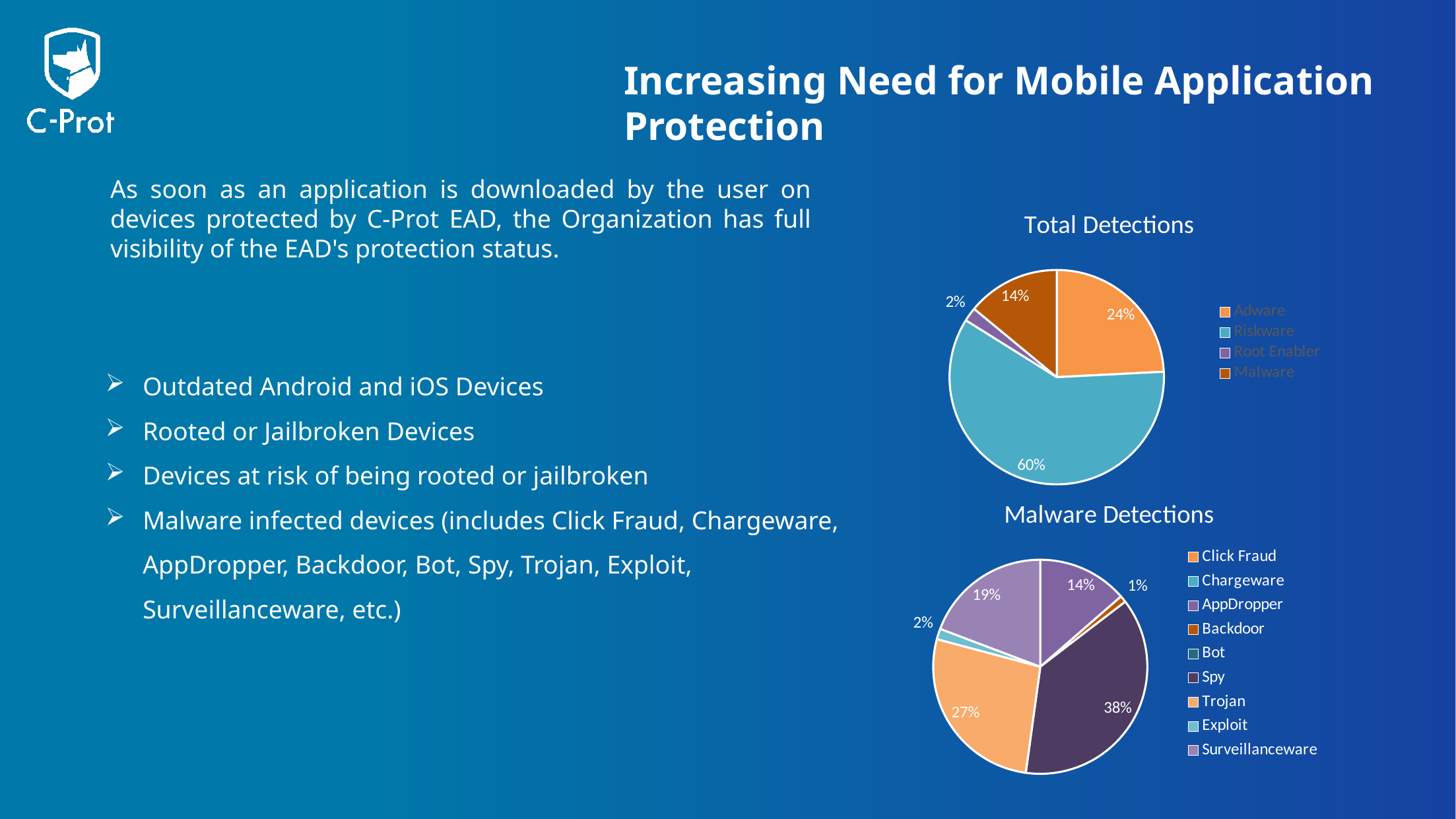
In the Total Detections chart, which category has the smallest slice? Root Enabler In the Total Detections chart, what share of detections is Malware? 14% How many entries does the legend of the Malware Detections chart list? 9 In the Total Detections chart, what share of detections is Riskware? 60% In the Malware Detections chart, what share is Trojan? 27% How many categories does the legend of the Total Detections chart list? 4 In the Total Detections chart, how many percentage points larger is Riskware than Adware? 36 In the Total Detections chart, which category has the largest slice? Riskware In the Malware Detections chart, which is larger, Spy or Surveillanceware? Spy What kind of chart is the Total Detections chart? pie chart In the Malware Detections chart, what share is Spy? 38% In the Total Detections chart, what share of detections is Adware? 24%